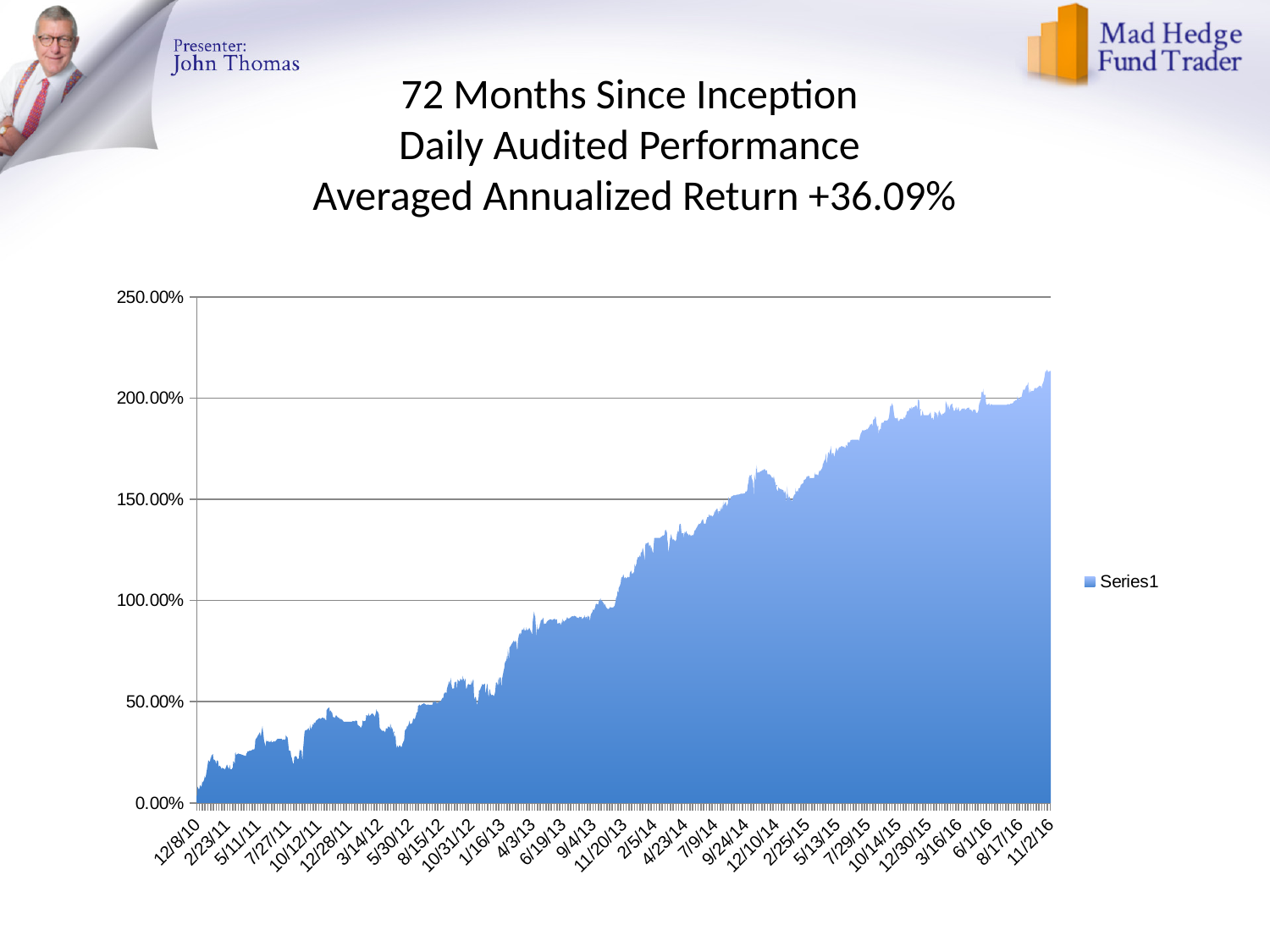
What is the highest value shown on the vertical axis? 250.00% What kind of chart is shown on the slide? area chart Is the value at 5/30/12 greater or less than 50.00%? less Is the value at 12/8/10 greater or less than 50.00%? less What is the name of the series shown in the legend? Series1 Do the values generally rise or fall from 12/8/10 to 11/2/16? rise Is the value at 11/2/16 greater or less than 200.00%? greater Which is larger, the value at 11/2/16 or the value at 12/8/10? 11/2/16 How many series does the legend list? 1